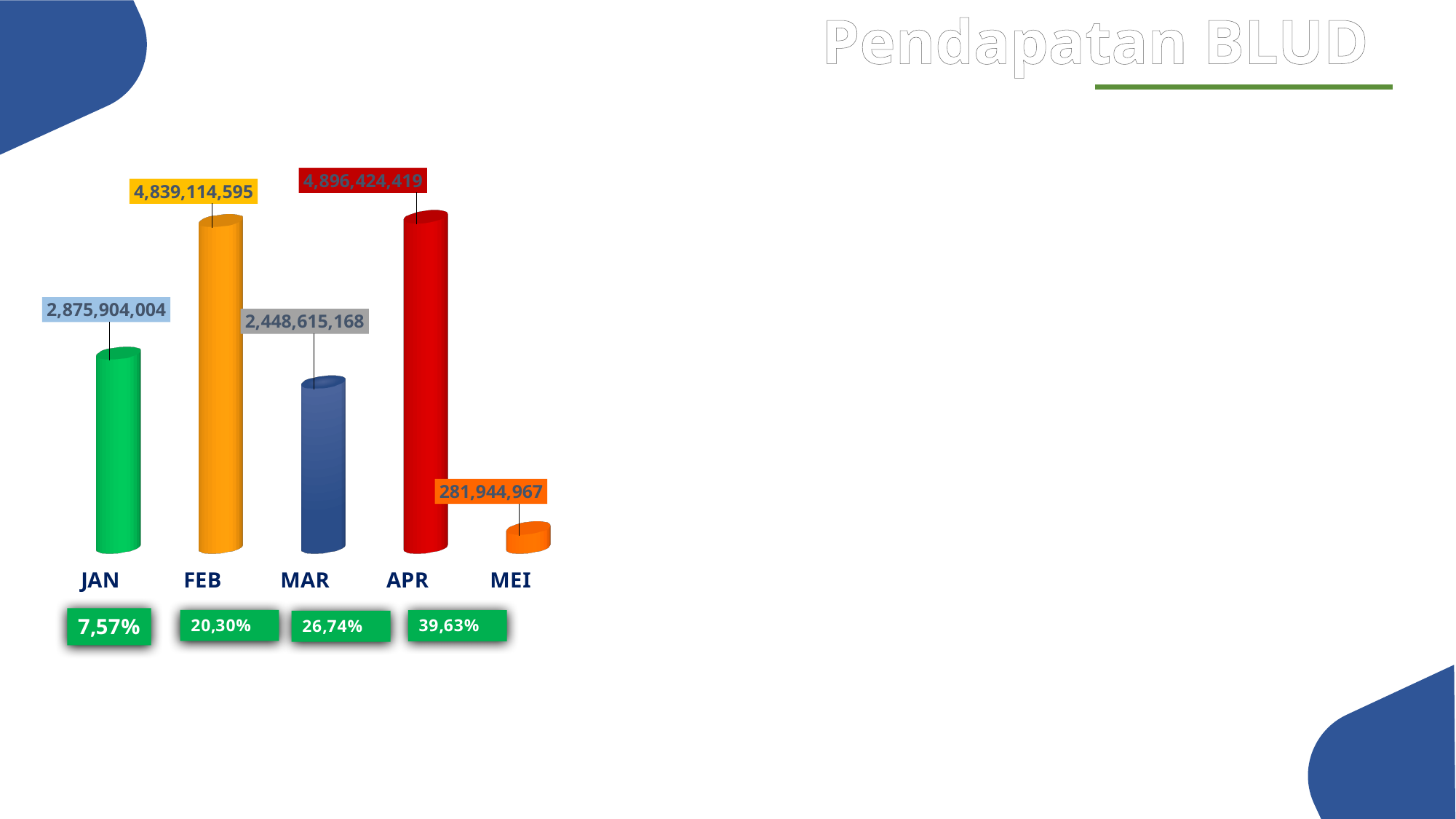
Which month has the highest value? APR What is the value for MEI? 281,944,967 What percentage is shown in the box below APR? 39,63% Which month has the lowest value? MEI Which is larger, the value for JAN or the value for MAR? JAN What is the value for JAN? 2,875,904,004 What is the difference between the values for JAN and MAR? 427,288,836 How many months are shown in the chart? 5 What is the value for FEB? 4,839,114,595 What is the difference between the values for APR and FEB? 57,309,824 What kind of chart is shown on the slide? bar chart What is the title of the slide? Pendapatan BLUD